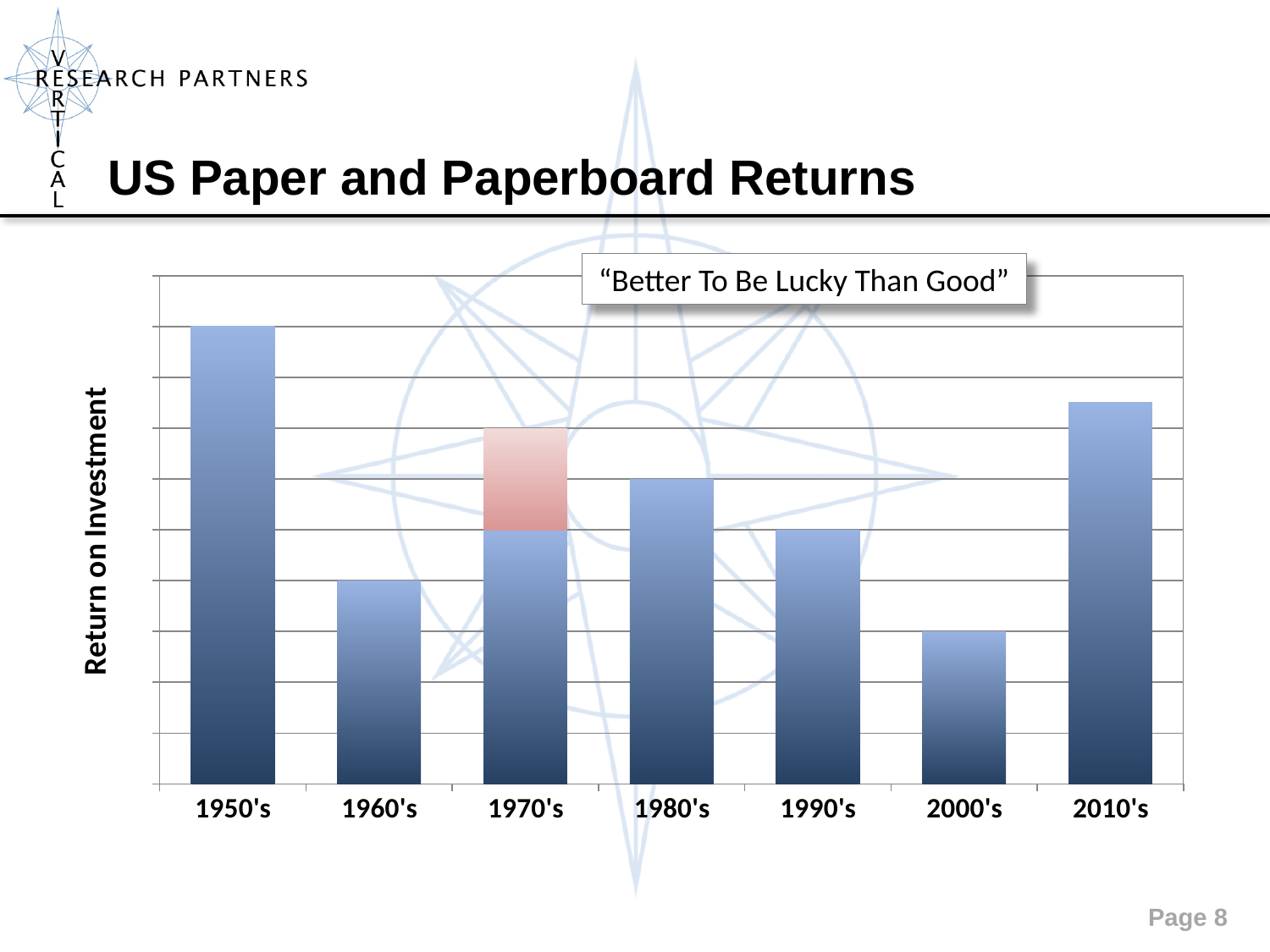
Which decade has the higher return on investment, 2010's or 1980's? 2010's Do the values rise or fall from the 1980's to the 2000's? Fall What kind of chart is shown on the slide? Bar chart What is the label on the vertical axis of the chart? Return on Investment Which decade has the higher return on investment, 1950's or 2010's? 1950's Which decade has the higher return on investment, 1960's or 2000's? 1960's Which decade has the highest return on investment? 1950's What is the title of the slide's chart? US Paper and Paperboard Returns Which decade has the lowest return on investment? 2000's How many decades are shown on the x axis of the chart? 7